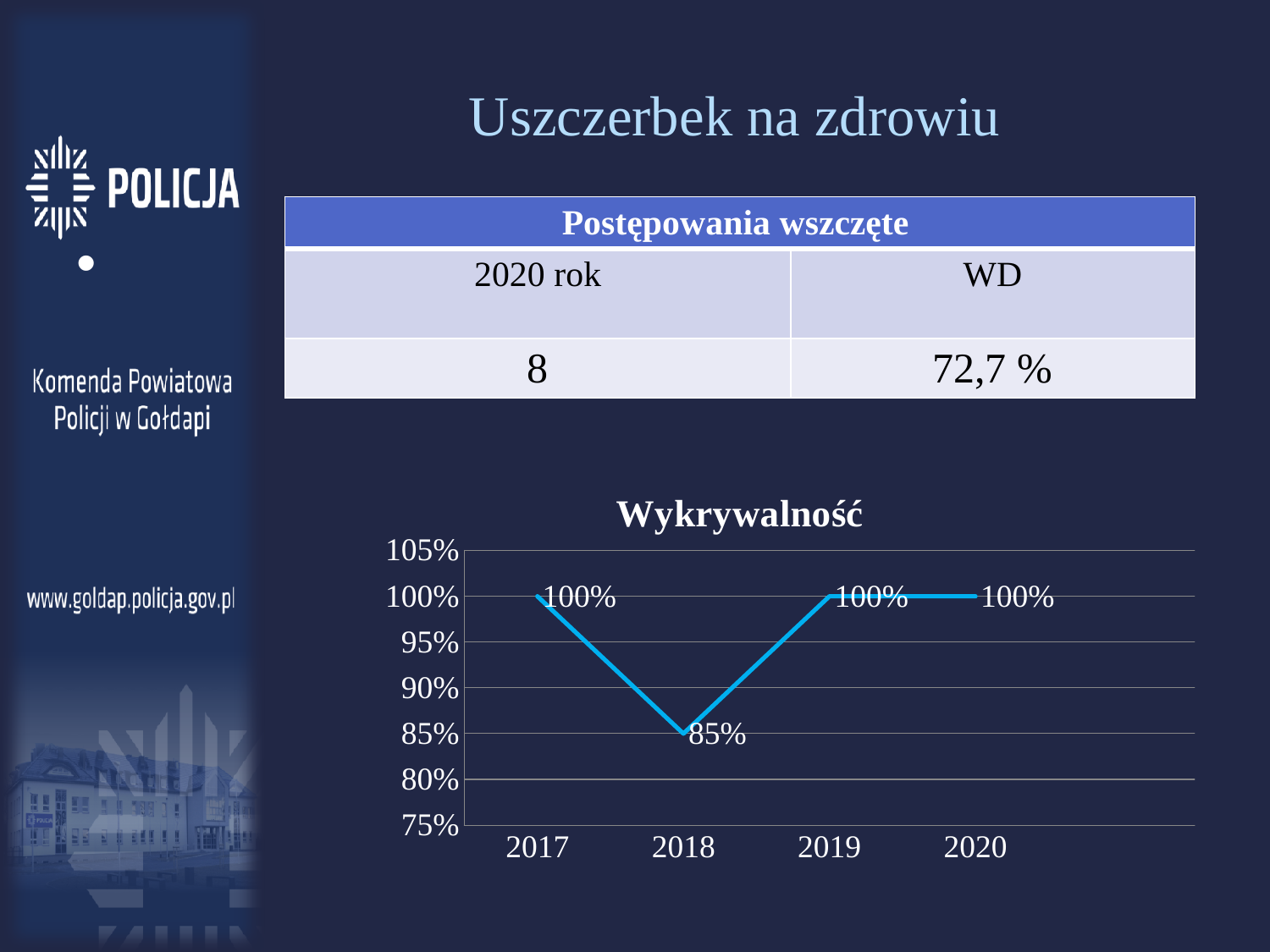
How many years are plotted in the Wykrywalność chart? 4 Does the value rise or fall from 2018 to 2019 in the Wykrywalność chart? rise What is the highest value shown on the vertical axis of the Wykrywalność chart? 105% What kind of chart is the Wykrywalność chart? line chart Is the value for 2018 in the Wykrywalność chart greater or less than 90%? less What is the value for 2017 in the Wykrywalność chart? 100% Which is larger in the Wykrywalność chart, the value for 2017 or the value for 2018? 2017 What is the value for 2020 in the Wykrywalność chart? 100% What is the title of the chart on the slide? Wykrywalność Which year has the lowest value in the Wykrywalność chart? 2018 What is the difference between the values for 2019 and 2018 in the Wykrywalność chart? 15% What is the value for 2018 in the Wykrywalność chart? 85%